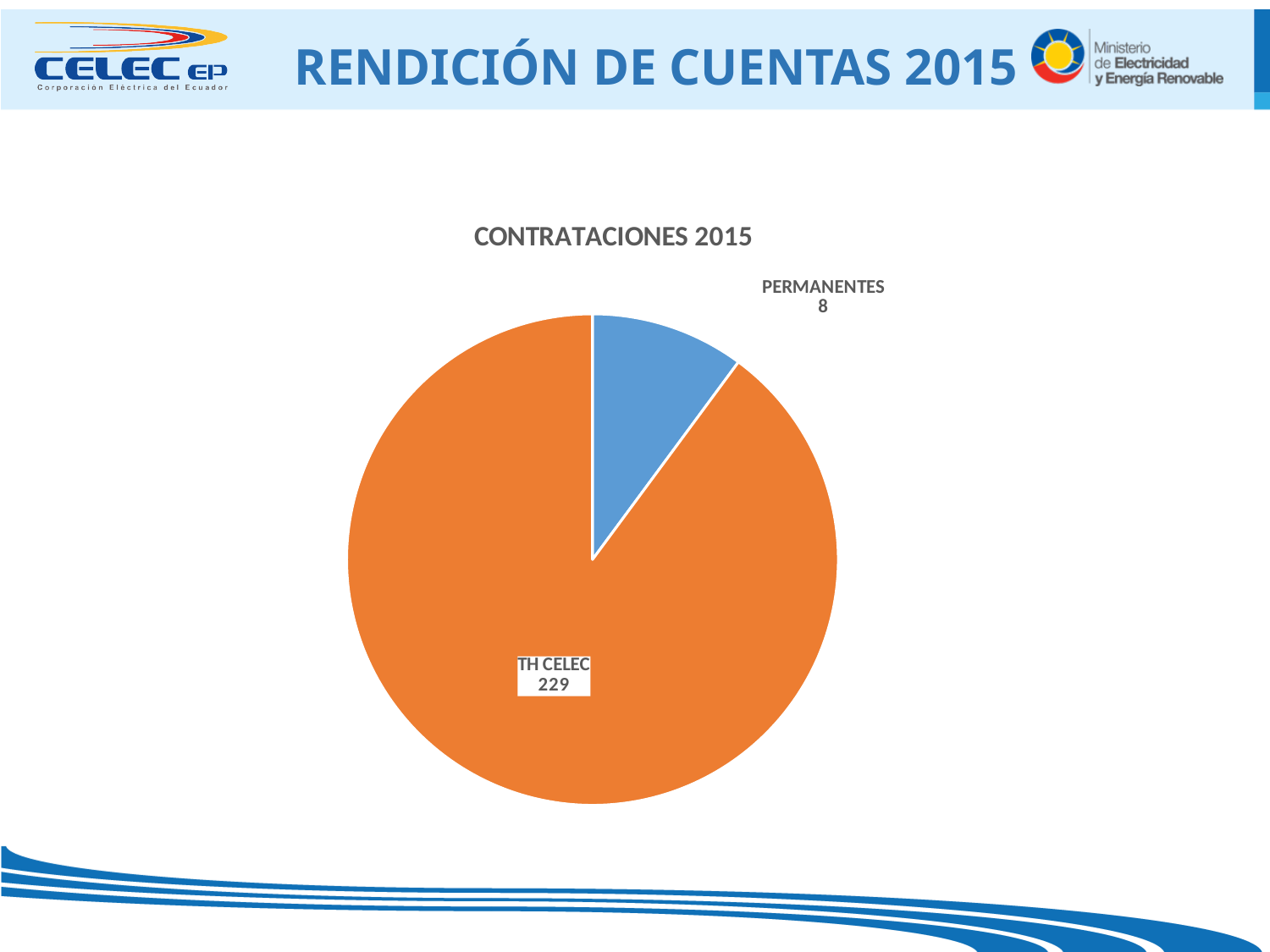
Which category has the largest slice of the pie? TH CELEC Which is larger, the value for TH CELEC or the value for PERMANENTES? TH CELEC How many slices does the pie chart have? 2 What kind of chart is shown on the slide? pie chart What is the value for TH CELEC? 229 Which category has the smallest slice of the pie? PERMANENTES What is the title of the chart? CONTRATACIONES 2015 What is the difference between the TH CELEC value and the PERMANENTES value? 221 What colour is the TH CELEC slice? orange What is the value for PERMANENTES? 8 What is the total of all slices in the pie chart? 237